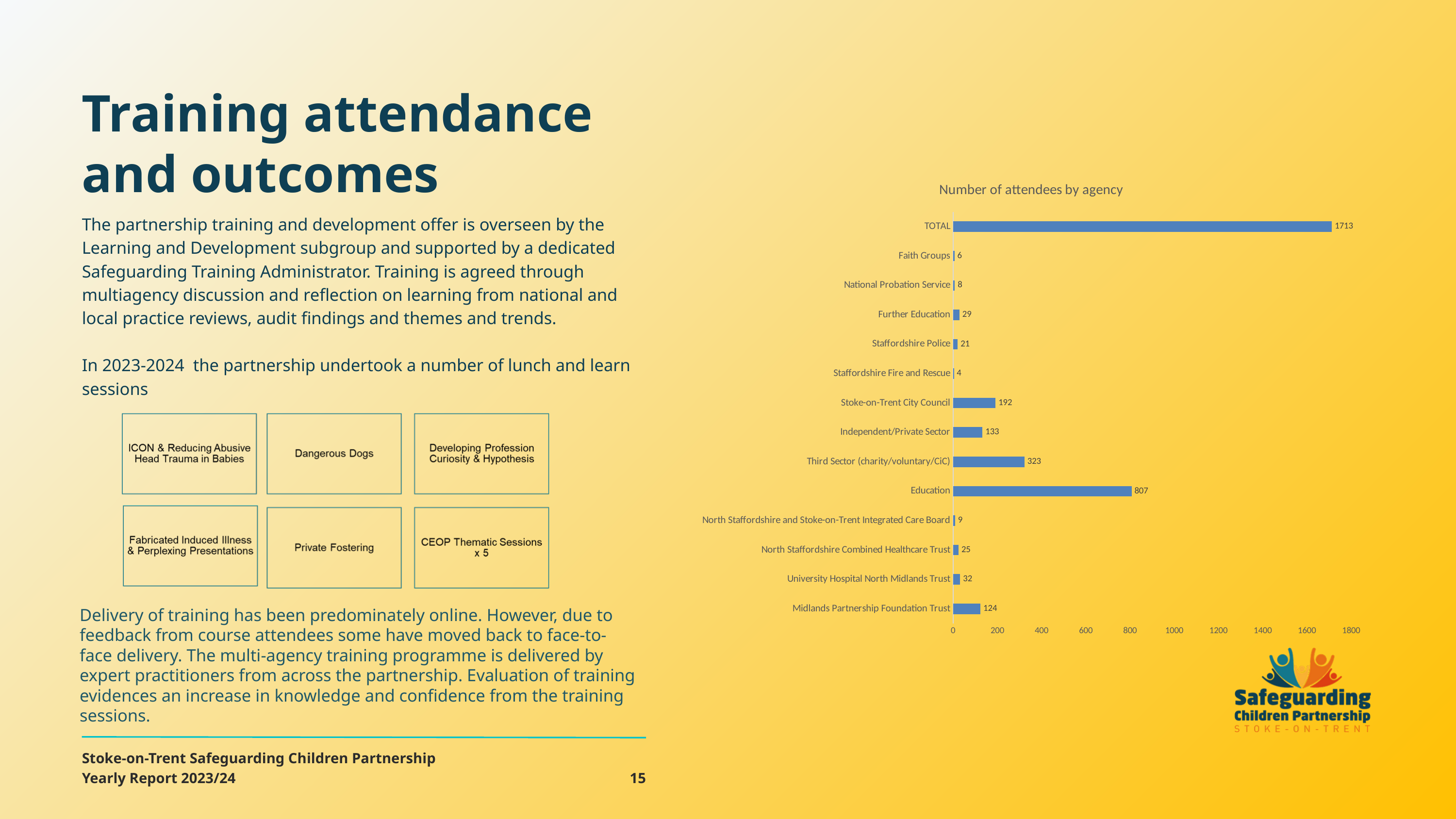
What is the number of attendees for Midlands Partnership Foundation Trust? 124 What type of chart is used to show the number of attendees by agency? Bar chart What is the value shown for the TOTAL bar? 1713 Which agency has the lowest number of attendees? Staffordshire Fire and Rescue How many bars are plotted in the chart, including the TOTAL bar? 14 What is the number of attendees for Third Sector (charity/voluntary/CiC)? 323 Which has more attendees, Further Education or Staffordshire Police? Further Education Excluding the TOTAL bar, which agency has the highest number of attendees? Education What is the title of the chart? Number of attendees by agency What is the number of attendees for Education? 807 What is the difference in attendees between Stoke-on-Trent City Council and Independent/Private Sector? 59 Is the value for Education greater or less than 600? greater